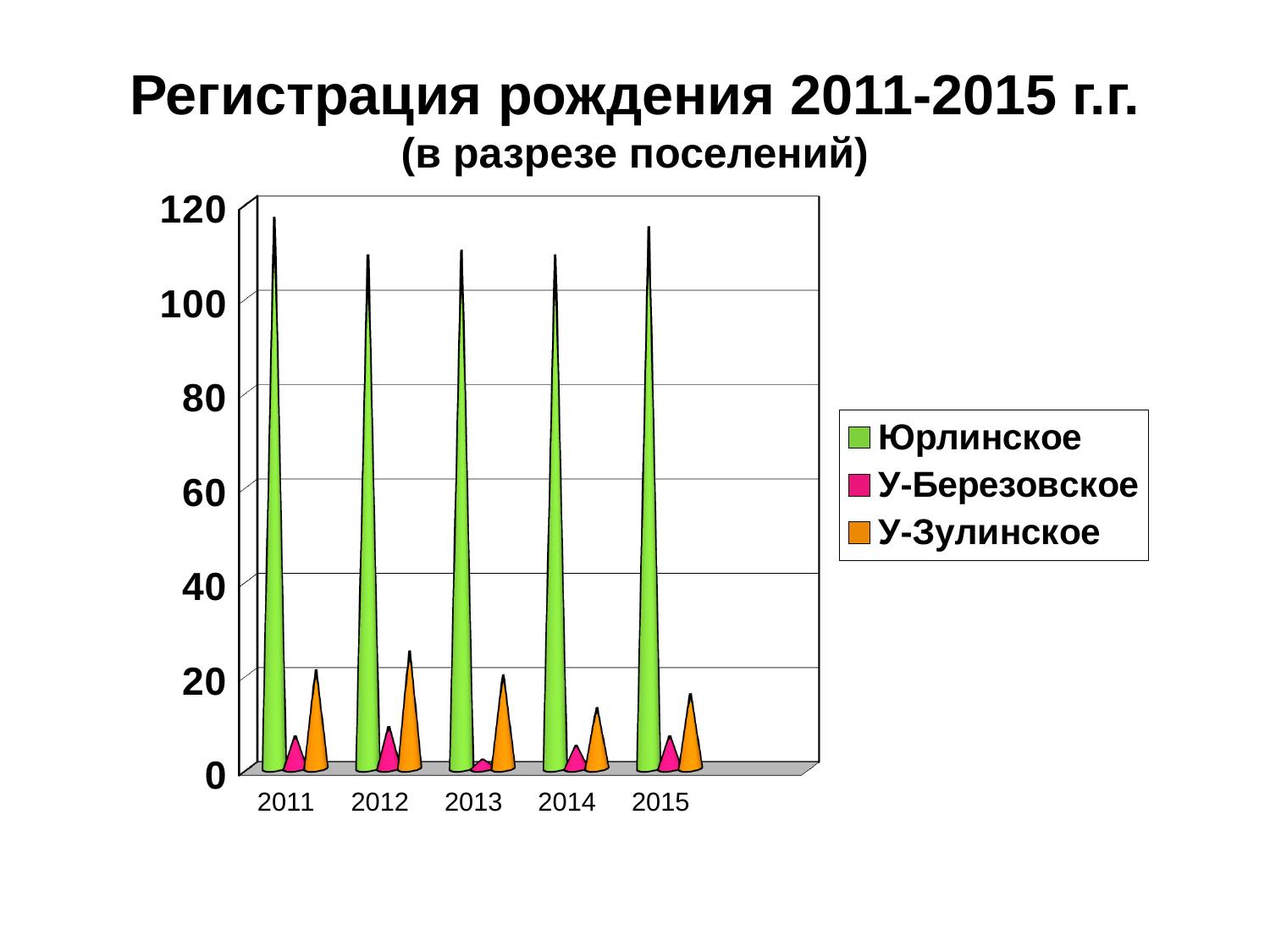
How many years are shown on the x axis? 5 Is the value for Юрлинское in 2011 greater or less than 100? greater Is the value for У-Зулинское in 2014 greater or less than 20? less Is the value for У-Зулинское in 2012 greater or less than 20? greater In which year is the value for У-Березовское the lowest? 2013 Which series is shown in green in the legend? Юрлинское How many series does the legend list? 3 Which series has the larger value in 2015, Юрлинское or У-Зулинское? Юрлинское Which series has the larger value in 2011, У-Березовское or У-Зулинское? У-Зулинское What kind of chart is shown on the slide? bar chart In which year is the value for У-Зулинское the highest? 2012